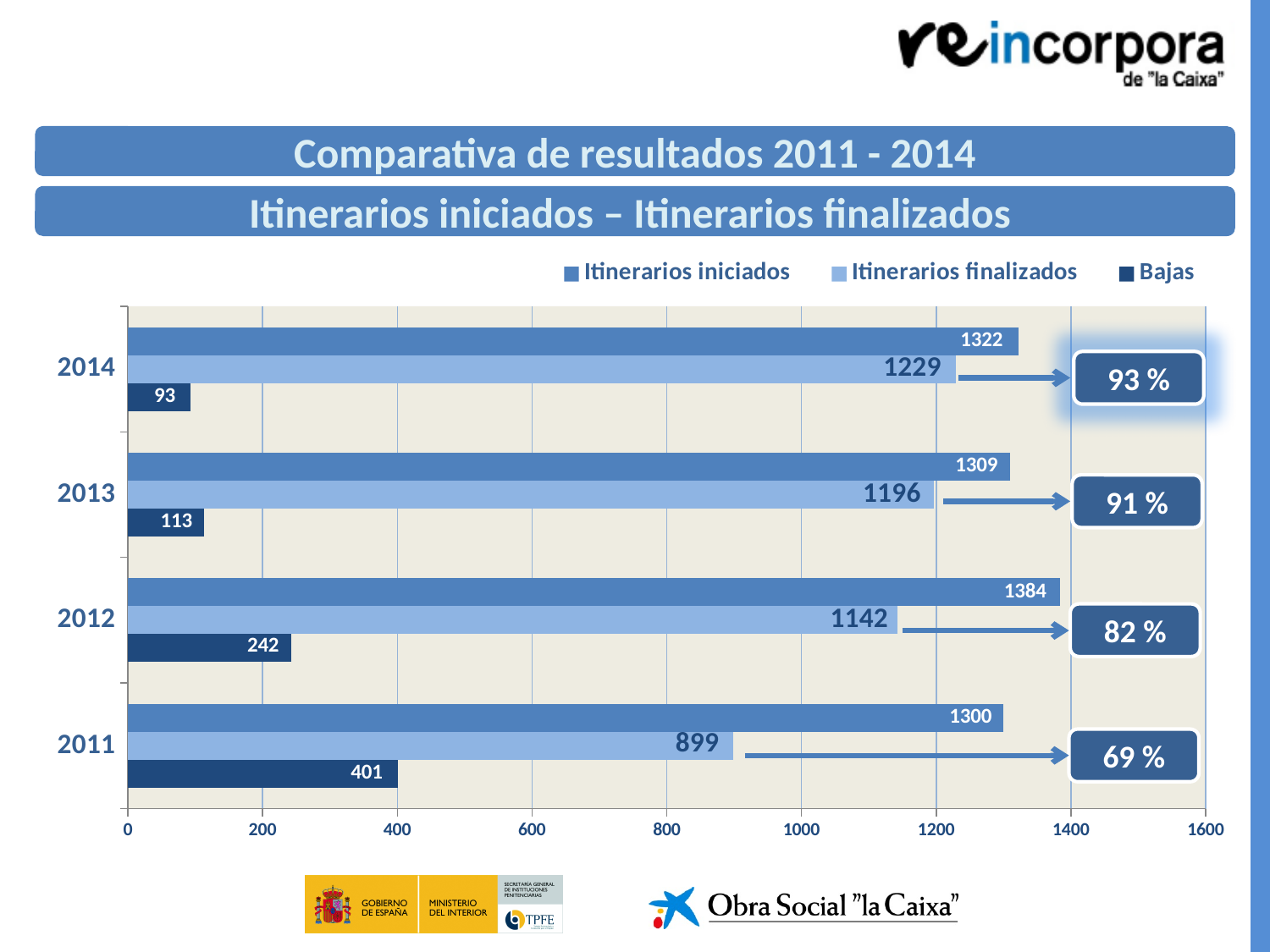
What is the difference between Itinerarios iniciados and Itinerarios finalizados in 2013? 113 What is the value of Itinerarios iniciados for 2014? 1322 What is the value of Bajas for 2012? 242 Which is larger: Itinerarios finalizados in 2012 or Itinerarios finalizados in 2013? 2013 Which year has the lowest value for Bajas? 2014 Which year has the highest value for Itinerarios iniciados? 2012 How many years are shown on the chart? 4 How many series does the legend list? 3 Do the Bajas values rise or fall from 2011 to 2014? Fall What percentage is shown next to the 2014 bars? 93 % What is the value of Itinerarios finalizados for 2011? 899 What kind of chart is shown on the slide? Bar chart